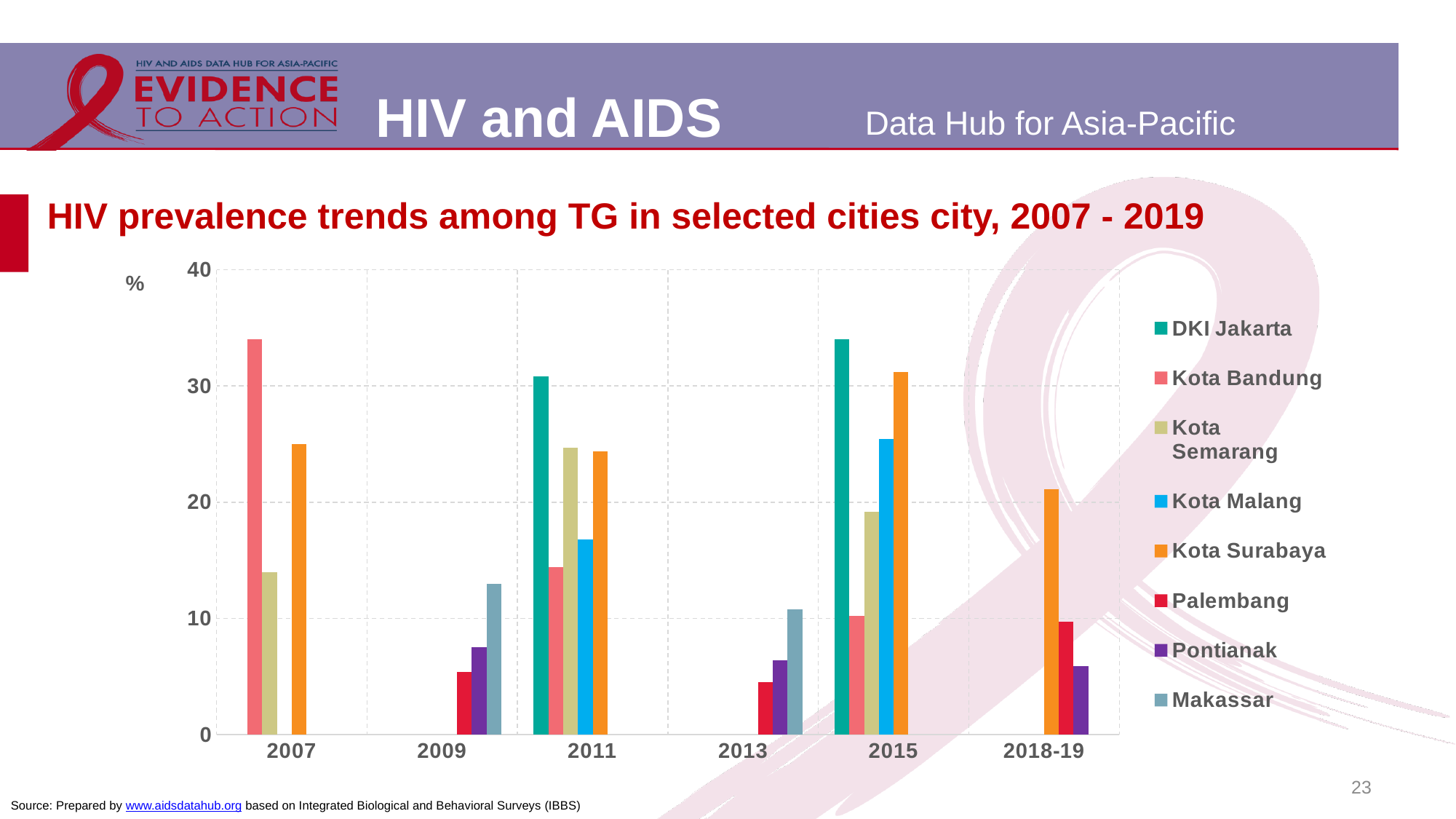
Is the value for Kota Malang in 2015 greater or less than 20? greater Is the value for Makassar in 2009 greater or less than 10? greater In 2015, which is larger: the value for DKI Jakarta or the value for Kota Surabaya? DKI Jakarta What is the title of the chart on the slide? HIV prevalence trends among TG in selected cities city, 2007 - 2019 Is the value for Palembang in 2013 greater or less than 10? less How many cities are listed in the chart's legend? 8 How many time periods are shown along the x axis of the chart? 6 What kind of chart is shown on the slide? Bar chart Does the value for Kota Bandung rise or fall from 2007 to 2015? Fall Which city has the highest HIV prevalence in 2011? DKI Jakarta Which city has the lowest HIV prevalence in 2015? Kota Bandung